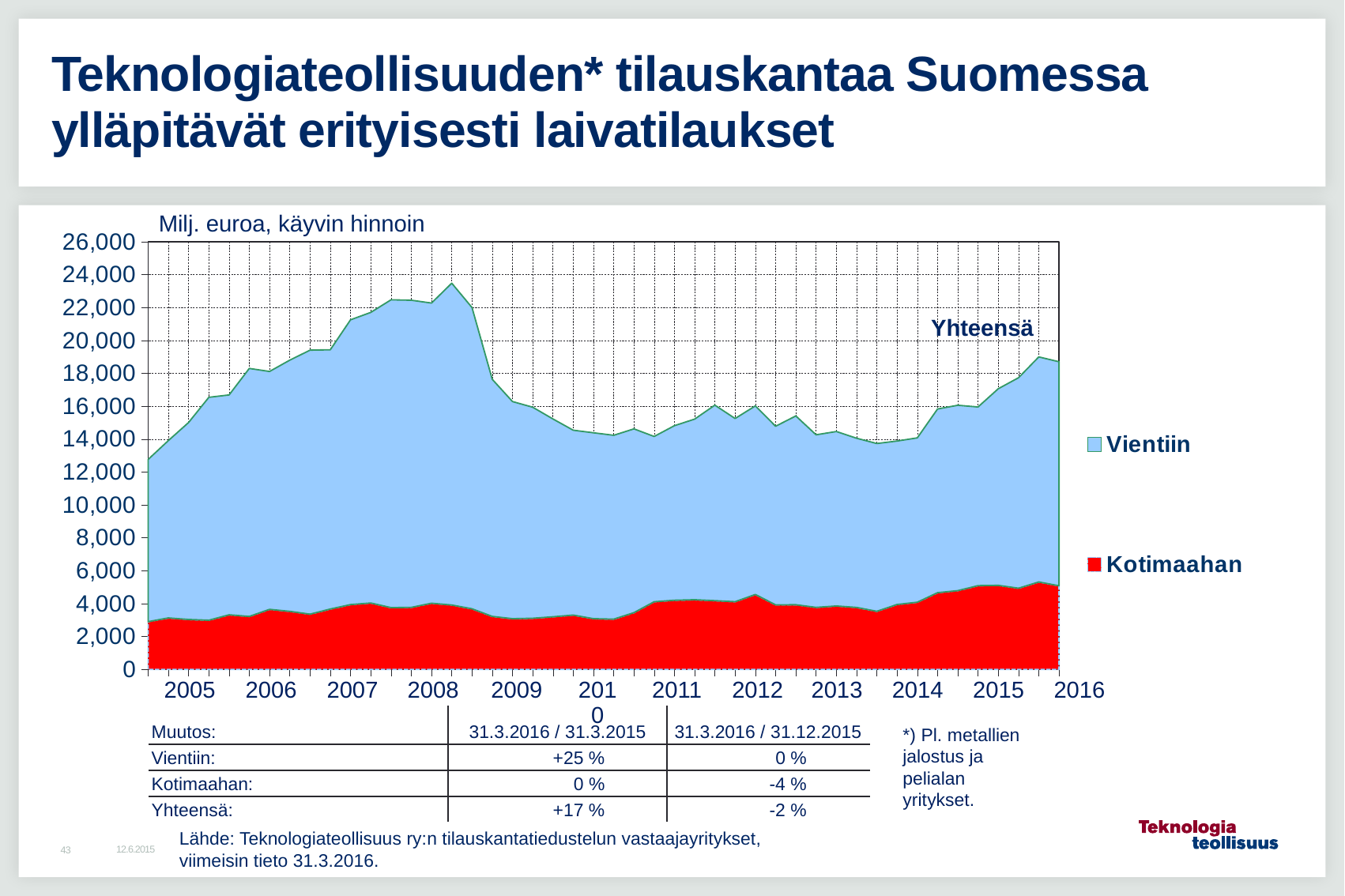
What kind of chart is shown on the slide? Stacked area chart Is the Kotimaahan value at the end of the series (2016) greater or less than 4,000? greater Does the total order backlog rise or fall between 2008 and 2009? fall Is the peak total value in 2008 greater or less than 22,000? greater Which series is larger throughout the chart, Vientiin or Kotimaahan? Vientiin How many year labels are shown along the x axis? 12 In which year does the total (Yhteensä) order backlog reach its highest point? 2008 Does the total order backlog rise or fall between 2005 and 2008? rise What unit label is shown above the chart's y axis? Milj. euroa, käyvin hinnoin Which two series are listed in the chart's legend? Vientiin and Kotimaahan How many series does the chart's legend list? 2